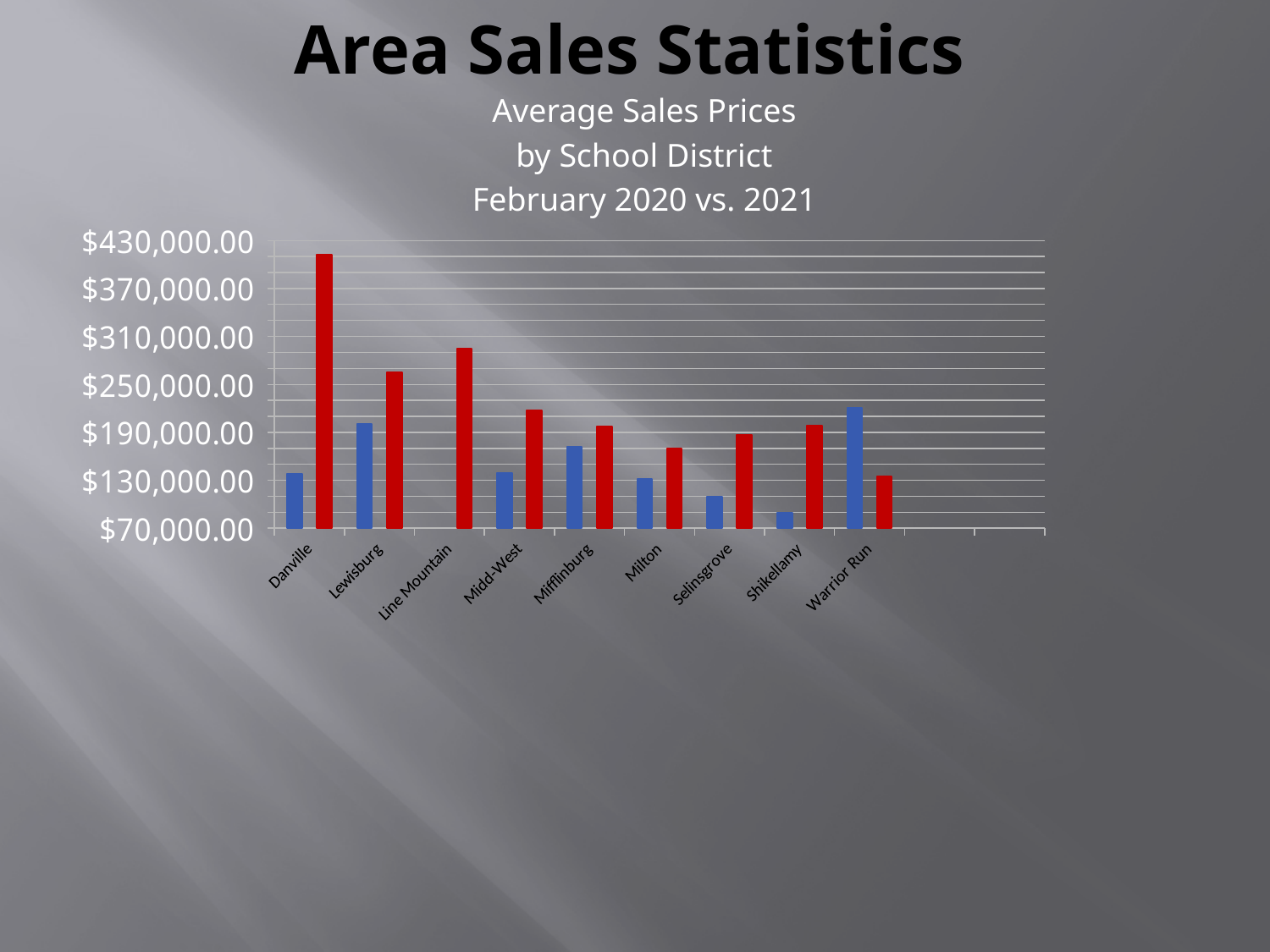
Which is taller, the red bar for Lewisburg or the red bar for Line Mountain? Line Mountain Which school district has the tallest red bar in the chart? Danville For Warrior Run, which bar is taller, the blue bar or the red bar? the blue bar Is the red bar for Danville greater or less than $370,000.00? greater How many school districts are shown on the x axis of the chart? 9 Which school district has the tallest blue bar in the chart? Warrior Run What kind of chart is shown on the slide? bar chart Which school district has the shortest blue bar in the chart? Shikellamy Is the red bar for Line Mountain greater or less than $250,000.00? greater Which school district has the shortest red bar in the chart? Warrior Run Is the blue bar for Shikellamy greater or less than $130,000.00? less Which school district in the chart has only a red bar and no blue bar? Line Mountain